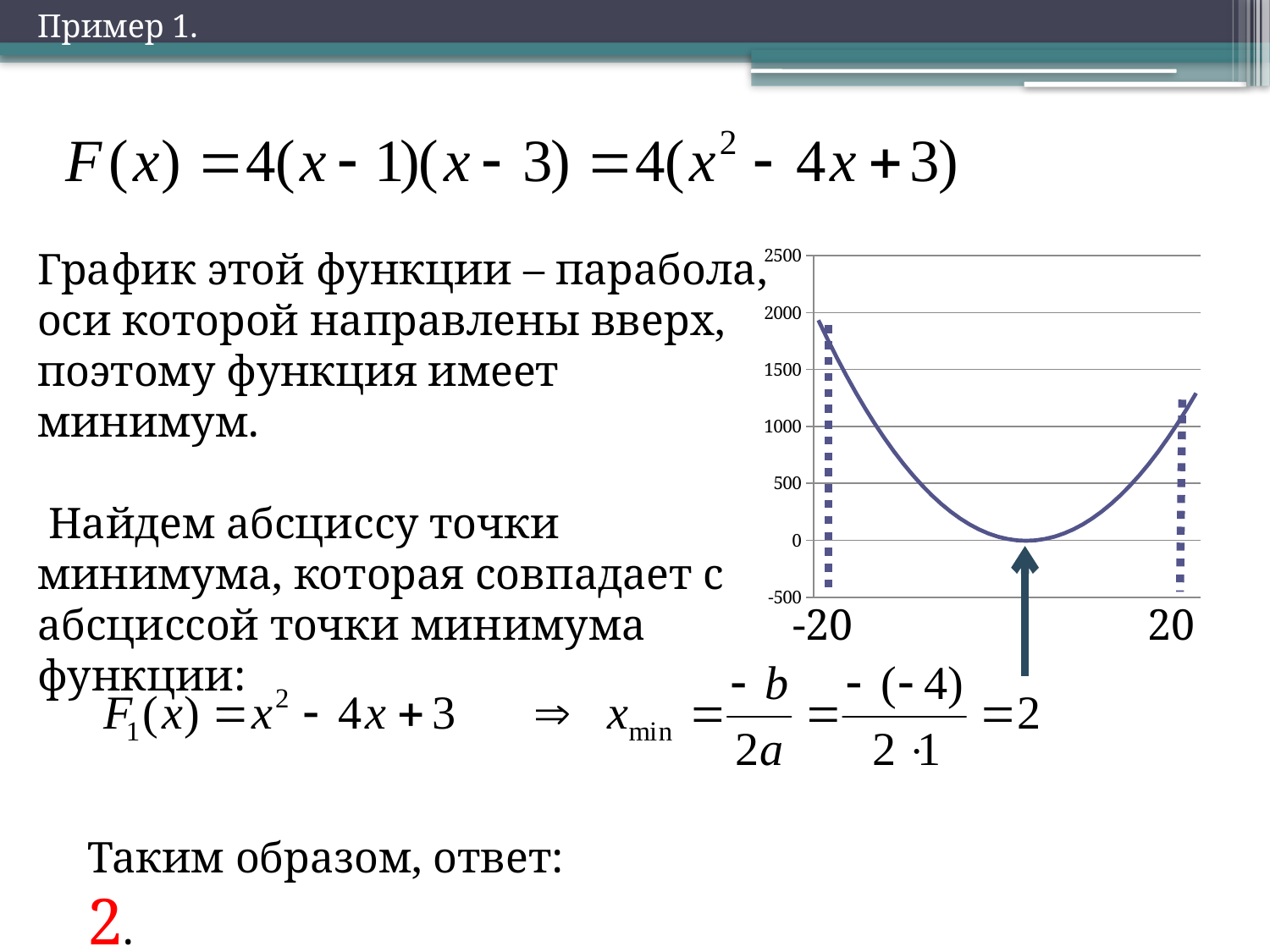
Is the minimum value of the curve greater or less than 500? less How does the curve behave moving from left to right along the x axis? it falls, then rises What is the lowest value labelled on the vertical axis of the chart? -500 What are the two x-axis labels shown under the chart? -20 and 20 Is the value of the curve at the left end of the chart greater or less than 1500? greater Which end of the curve is higher, the left end or the right end? the left end What kind of chart is shown on the slide? line chart Is the value of the curve at the right end of the chart greater or less than 1000? greater What is the highest value labelled on the vertical axis of the chart? 2500